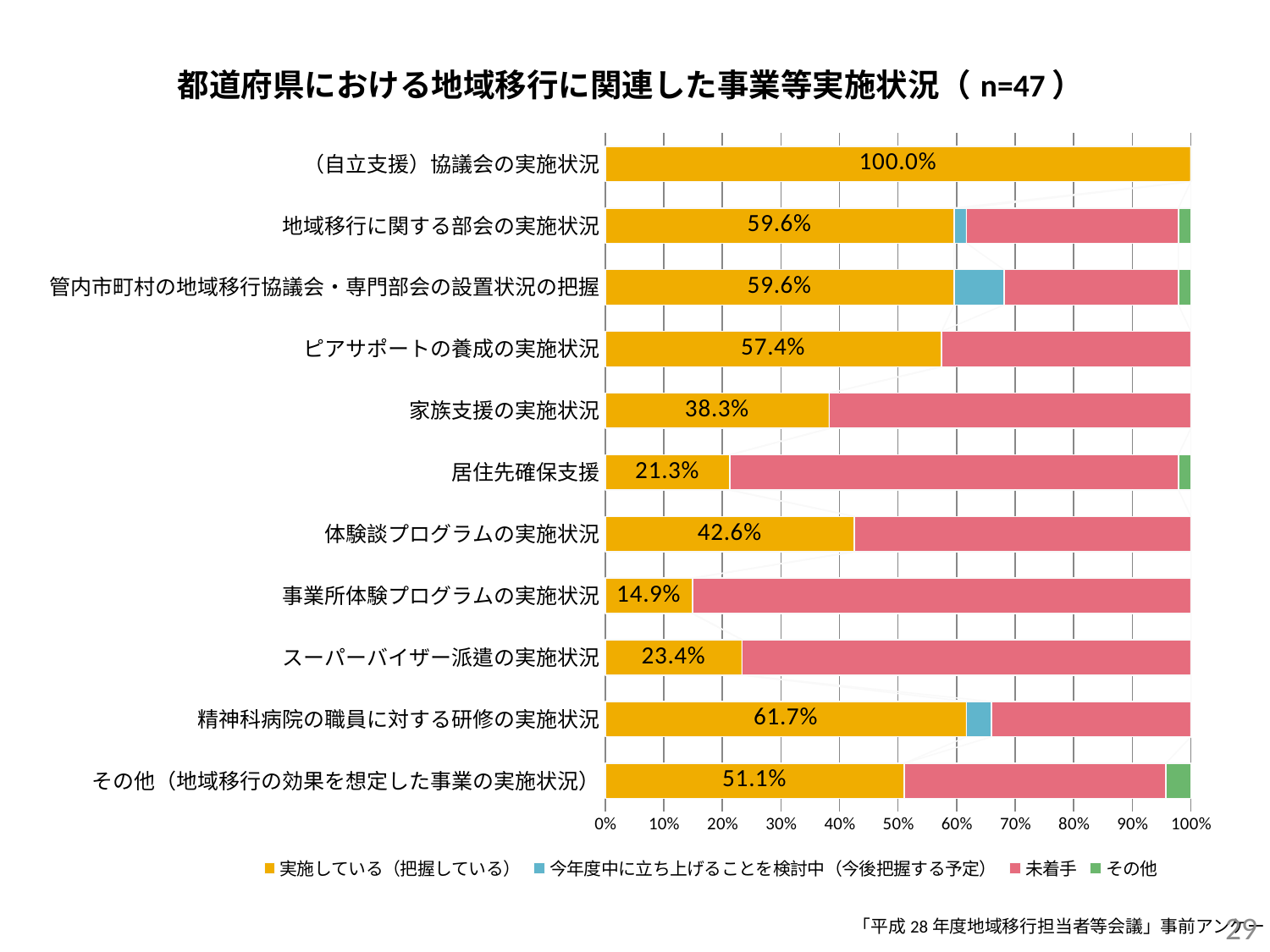
What is the value of 実施している（把握している） for 精神科病院の職員に対する研修の実施状況? 61.7% Which category has the highest value for 実施している（把握している）? （自立支援）協議会の実施状況 What is the difference between the 実施している（把握している） values for 精神科病院の職員に対する研修の実施状況 and ピアサポートの養成の実施状況? 4.3 percentage points What is the sample size (n) given in the chart title? n=47 What is the value of 実施している（把握している） for 家族支援の実施状況? 38.3% What is the value of 実施している（把握している） for スーパーバイザー派遣の実施状況? 23.4% What kind of chart is shown on the slide? Stacked horizontal bar chart How many series does the legend list? 4 Which has a larger 実施している（把握している） value: 体験談プログラムの実施状況 or 居住先確保支援? 体験談プログラムの実施状況 Which category has the lowest value for 実施している（把握している）? 事業所体験プログラムの実施状況 Is the 未着手 share for 事業所体験プログラムの実施状況 greater or less than 80%? greater How many categories are shown on the chart? 11